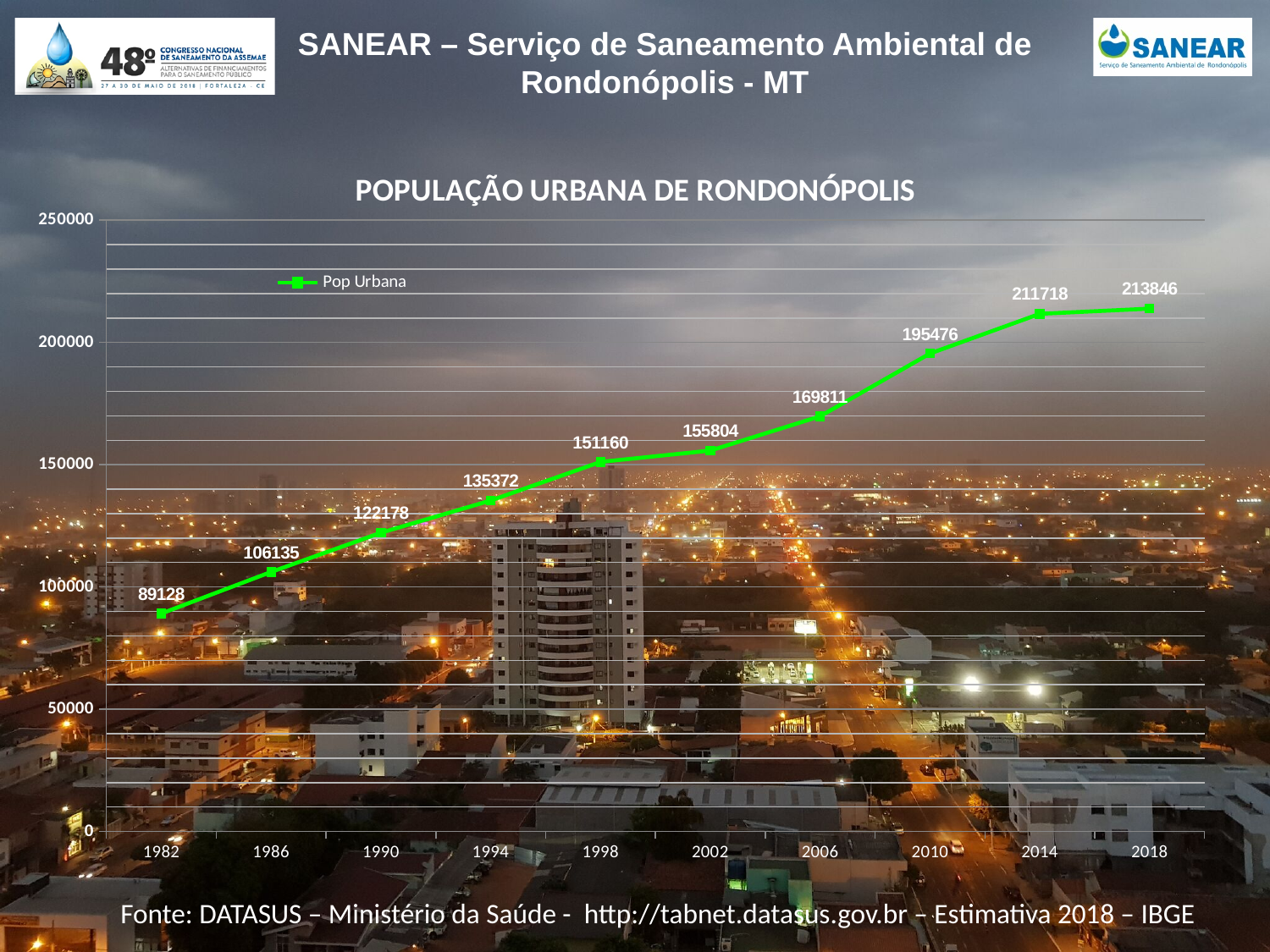
What is the difference between the urban population values for 2018 and 2014? 2128 What is the urban population value shown for 2010? 195476 What is the urban population value shown for 1982? 89128 Which year has the highest urban population value on the chart? 2018 Which year has the lowest urban population value on the chart? 1982 How many years (data points) are plotted on the chart? 10 Does the urban population rise or fall from 1982 to 2018? Rise Is the urban population value for 1990 greater or less than 100000? greater Which year has a larger urban population value, 1994 or 2002? 2002 What is the difference between the urban population values for 2010 and 2006? 25665 What kind of chart is used to show the urban population of Rondonópolis? Line chart What is the urban population value shown for 1998? 151160